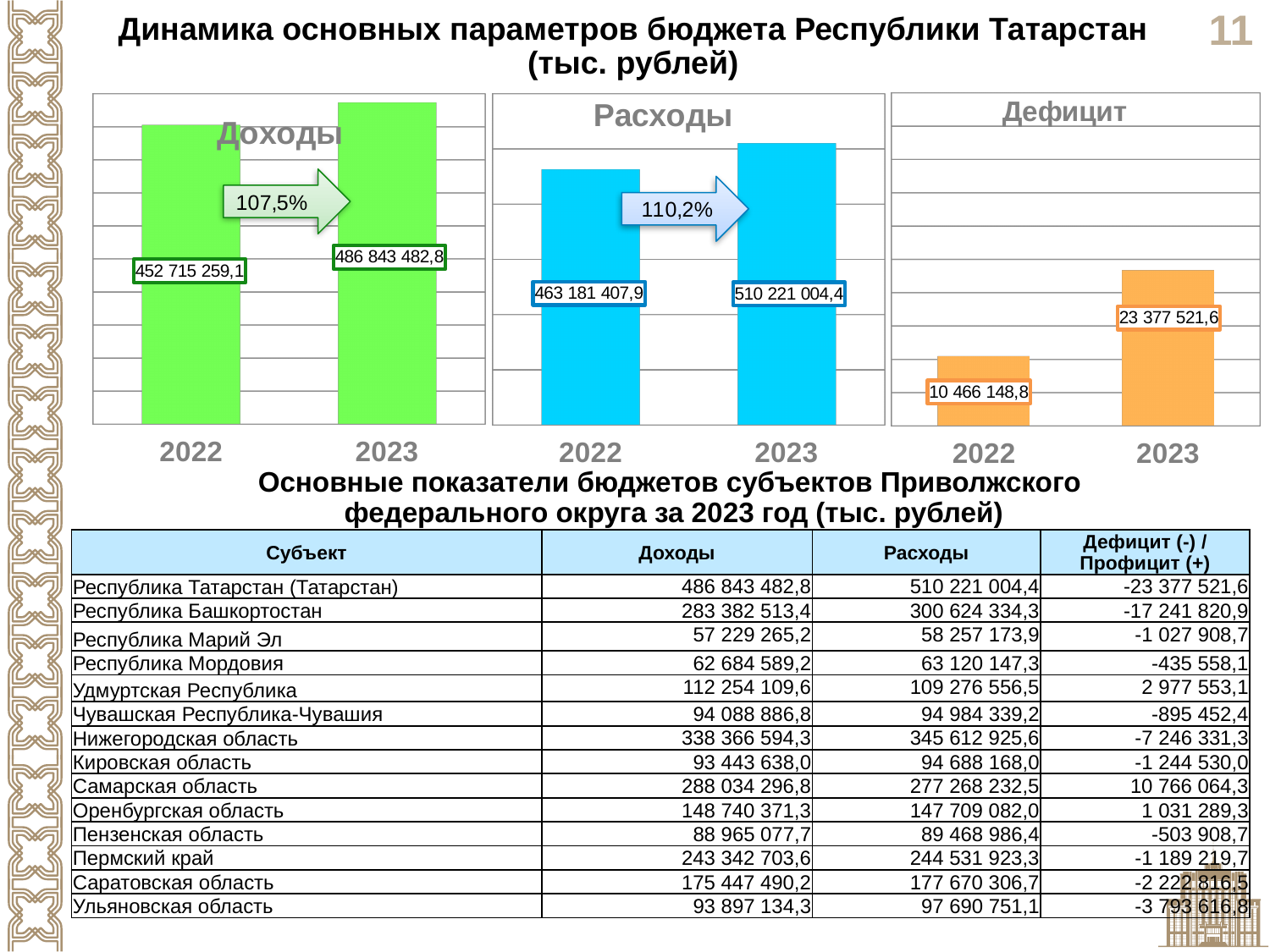
In the Расходы chart, what is the value for 2023? 510 221 004,4 What type of chart is the Доходы chart? Bar chart In the Расходы chart, what is the difference between the 2023 and 2022 values? 47 039 596,5 In the Дефицит chart, what is the value for 2022? 10 466 148,8 In the Доходы chart, what is the difference between the 2023 and 2022 values? 34 128 223,7 In the Дефицит chart, which year has the lower value? 2022 In the Доходы chart, what is the value for 2022? 452 715 259,1 In the Расходы chart, which year has the higher value? 2023 In the Расходы chart, what percentage is shown on the arrow between 2022 and 2023? 110,2% In the Доходы chart, what is the value for 2023? 486 843 482,8 In the Дефицит chart, what is the difference between the 2023 and 2022 values? 12 911 372,8 In the Дефицит chart, what is the value for 2023? 23 377 521,6